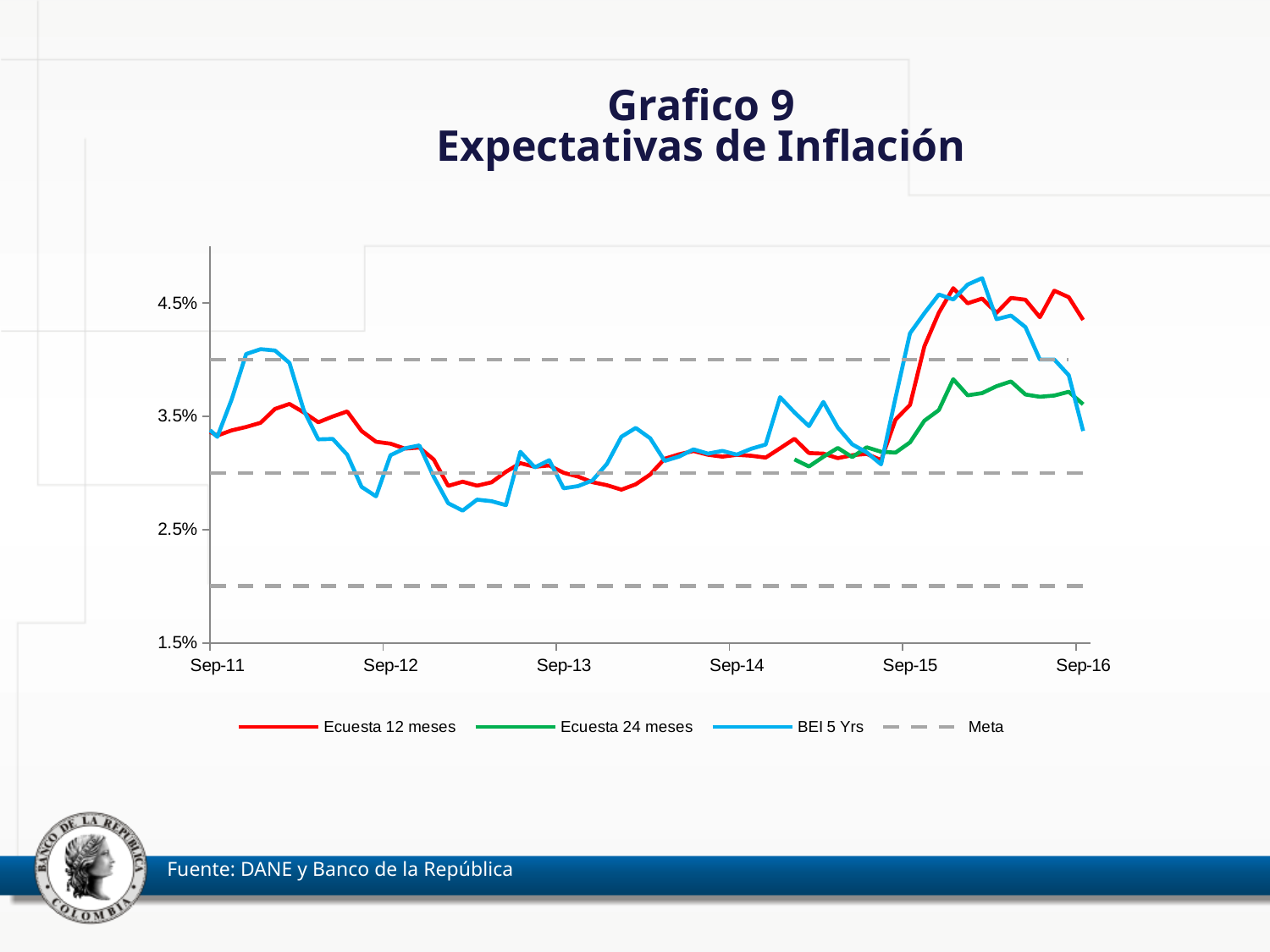
At Sep-16, which is higher: Ecuesta 12 meses or Ecuesta 24 meses? Ecuesta 12 meses What kind of chart is shown on the slide? Line chart How many date labels are shown on the x axis? 6 Which series is drawn as a dashed gray line? Meta Does Ecuesta 12 meses rise or fall between Sep-14 and Sep-15? rise At Sep-12, which is higher: Ecuesta 12 meses or BEI 5 Yrs? Ecuesta 12 meses Is the value of Ecuesta 12 meses at Sep-16 greater or less than 3.5%? greater Is the value of BEI 5 Yrs at Sep-12 greater or less than 3.5%? less What is the title of the chart? Grafico 9 Expectativas de Inflación Does BEI 5 Yrs rise or fall between Sep-11 and Sep-12? fall How many series does the legend list? 4 Is the value of Ecuesta 12 meses at Sep-13 greater or less than 3.5%? less